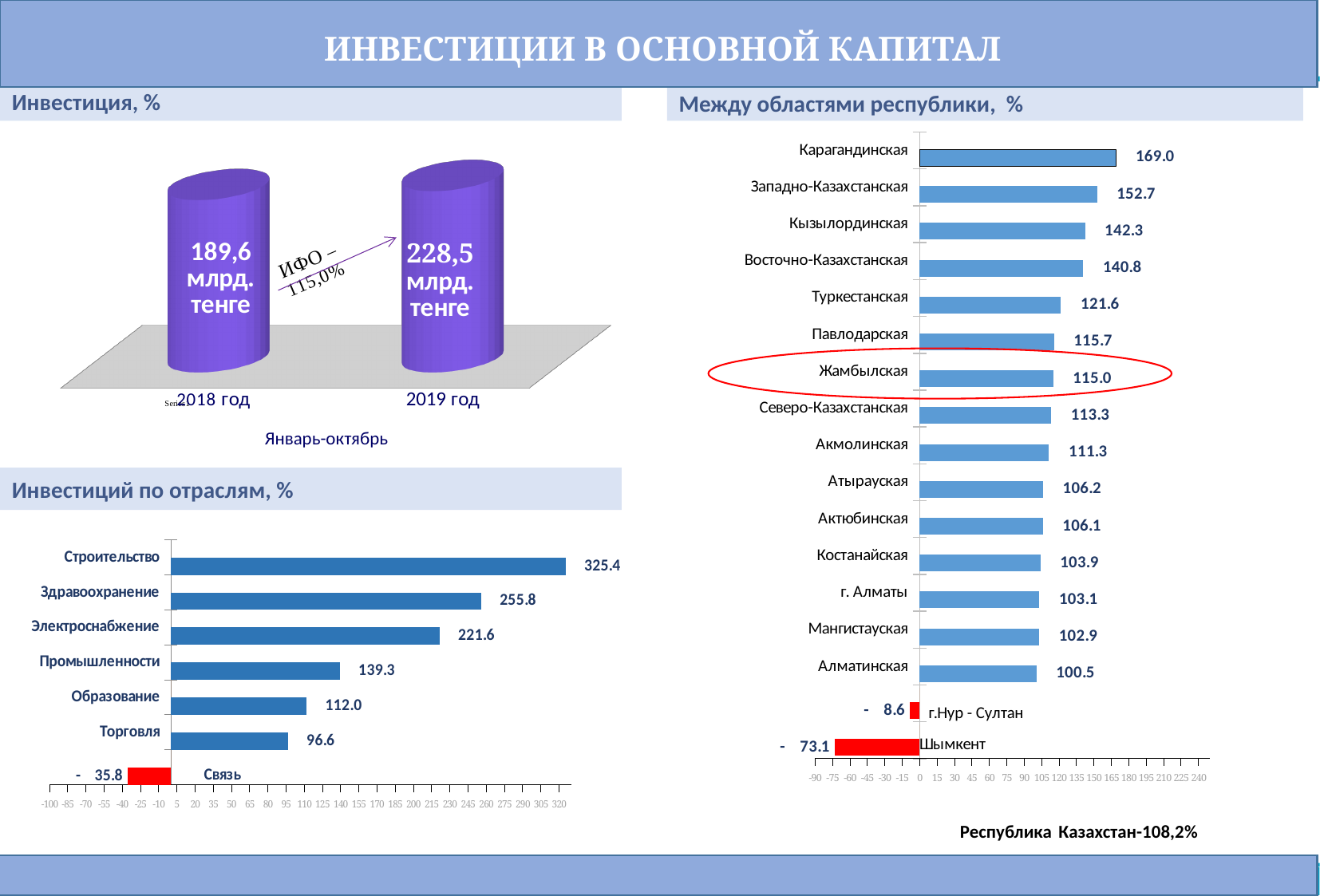
In the 'Инвестиций по отраслям, %' chart, how many categories are plotted? 7 In the 'Между областями республики, %' chart, which region has the lowest value? Шымкент In the 'Между областями республики, %' chart, what is the value for Жамбылская? 115.0 In the 'Инвестиция, %' chart, what is the value shown for 2019 год? 228,5 млрд. тенге In the 'Инвестиций по отраслям, %' chart, what is the difference between Строительство and Здравоохранение? 69.6 In the 'Между областями республики, %' chart, which region has the highest value? Карагандинская In the 'Между областями республики, %' chart, which is larger: Туркестанская or Павлодарская? Туркестанская In the 'Инвестиций по отраслям, %' chart, which category has the highest value? Строительство In the 'Инвестиция, %' chart, what is the value shown for 2018 год? 189,6 млрд. тенге In the 'Инвестиций по отраслям, %' chart, which category has the lowest value? Связь In the 'Инвестиций по отраслям, %' chart, what is the value for Электроснабжение? 221.6 What kind of chart is 'Между областями республики, %'? Bar chart